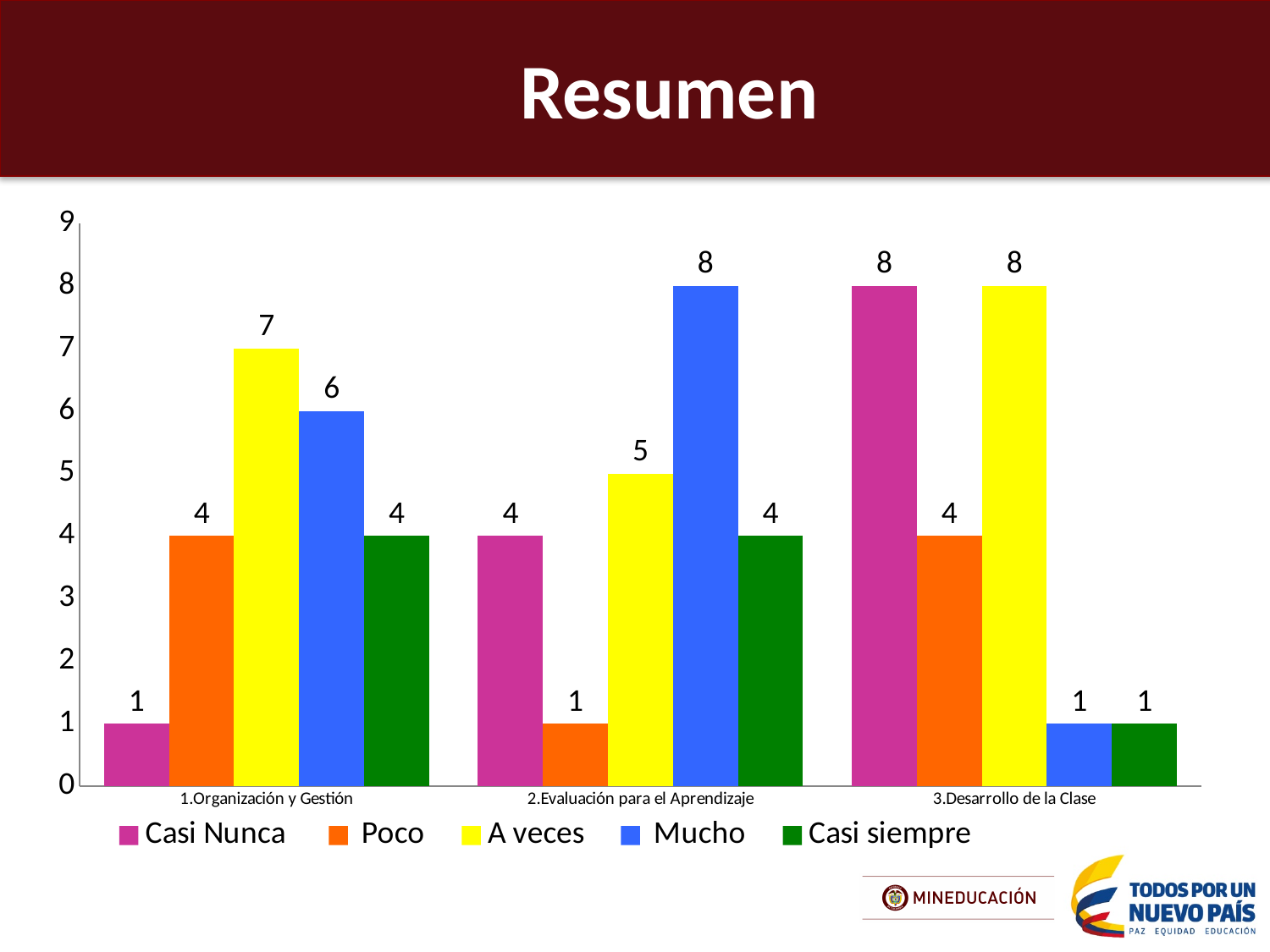
Which series has the highest value in the category "1.Organización y Gestión"? A veces Which is larger in the category "3.Desarrollo de la Clase": the value for "Poco" or the value for "Mucho"? Poco What is the value for "Mucho" in the category "2.Evaluación para el Aprendizaje"? 8 What is the difference between the "A veces" and "Mucho" values in the category "1.Organización y Gestión"? 1 What is the title of the slide containing the chart? Resumen How many categories are shown on the x axis? 3 What kind of chart is shown on the slide? Bar chart What is the value for "Poco" in the category "2.Evaluación para el Aprendizaje"? 1 Which series has the lowest value in the category "2.Evaluación para el Aprendizaje"? Poco What is the value for "Casi Nunca" in the category "3.Desarrollo de la Clase"? 8 What is the value for "A veces" in the category "1.Organización y Gestión"? 7 How many series does the legend list? 5